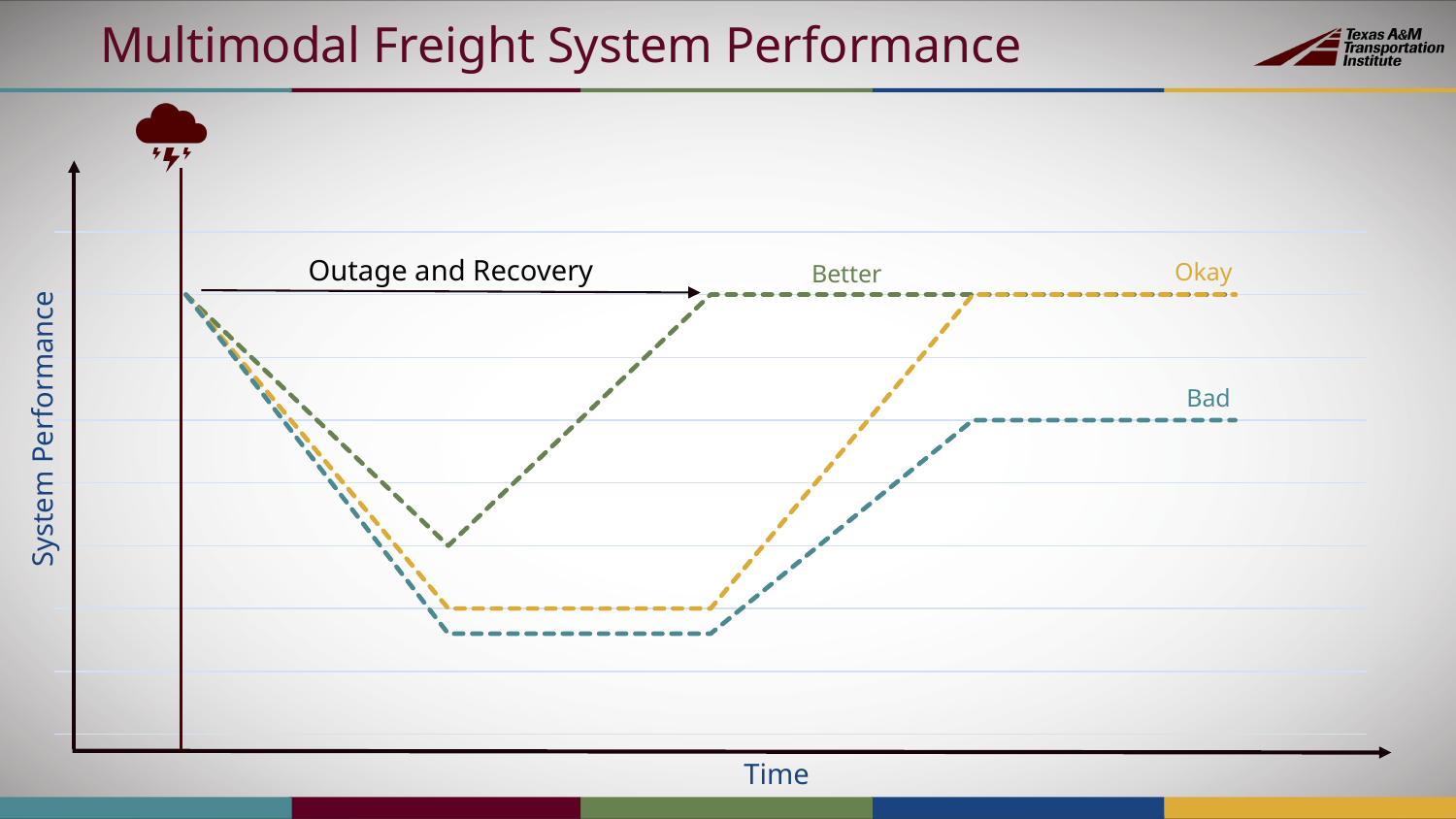
Which series has the smallest drop in performance during the outage? Better Which series returns to its original performance level first after the outage? Better What is the label on the horizontal axis of the chart? Time Immediately after the outage event, do all three series rise or fall? Fall What is the label on the vertical axis of the chart? System Performance What does the horizontal arrow annotation on the chart say? Outage and Recovery Does the 'Bad' series end higher or lower than the 'Okay' series at the right side of the chart? Lower Which series ends at the lowest system performance level at the right side of the chart? Bad How many dashed lines (series) are plotted on the chart? 3 Which series drops to the lowest point during the outage? Bad What kind of chart is shown on the slide? Line chart